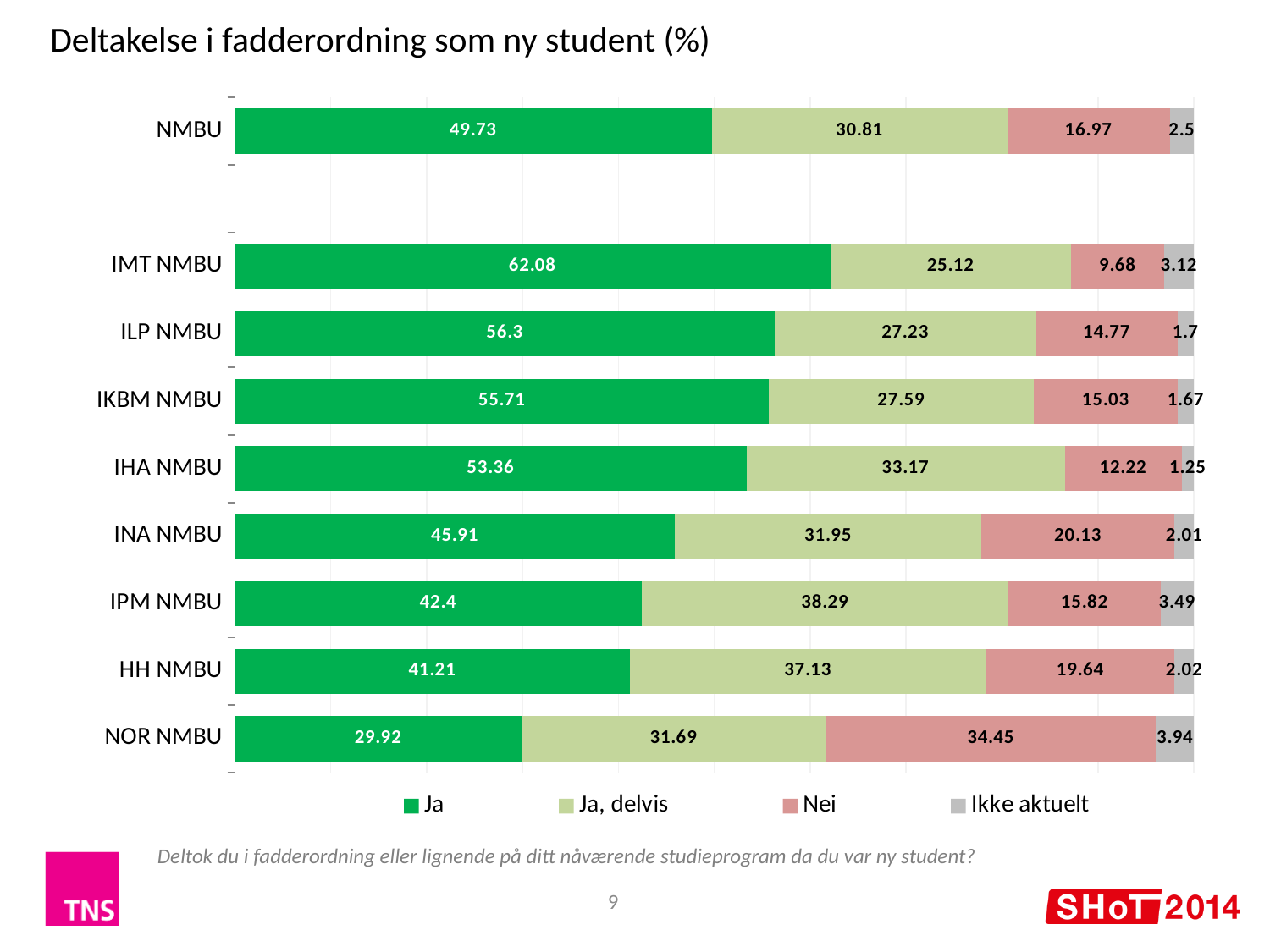
What is the difference between the 'Ja' values for NMBU and NOR NMBU? 19.81 What is the value of the 'Nei' series for NOR NMBU? 34.45 What is the value of the 'Ja, delvis' series for HH NMBU? 37.13 What is the total of the stacked bar for IMT NMBU? 100 Which has a larger 'Ja, delvis' value, IPM NMBU or HH NMBU? IPM NMBU Which category has the lowest 'Ja' value? NOR NMBU Which category has the highest 'Ja' value? IMT NMBU What is the value of the 'Ikke aktuelt' series for IPM NMBU? 3.49 What is the value of the 'Ja' series for IMT NMBU? 62.08 How many categories are shown on the y axis? 9 What kind of chart is shown on the slide? Stacked bar chart How many series does the legend list? 4